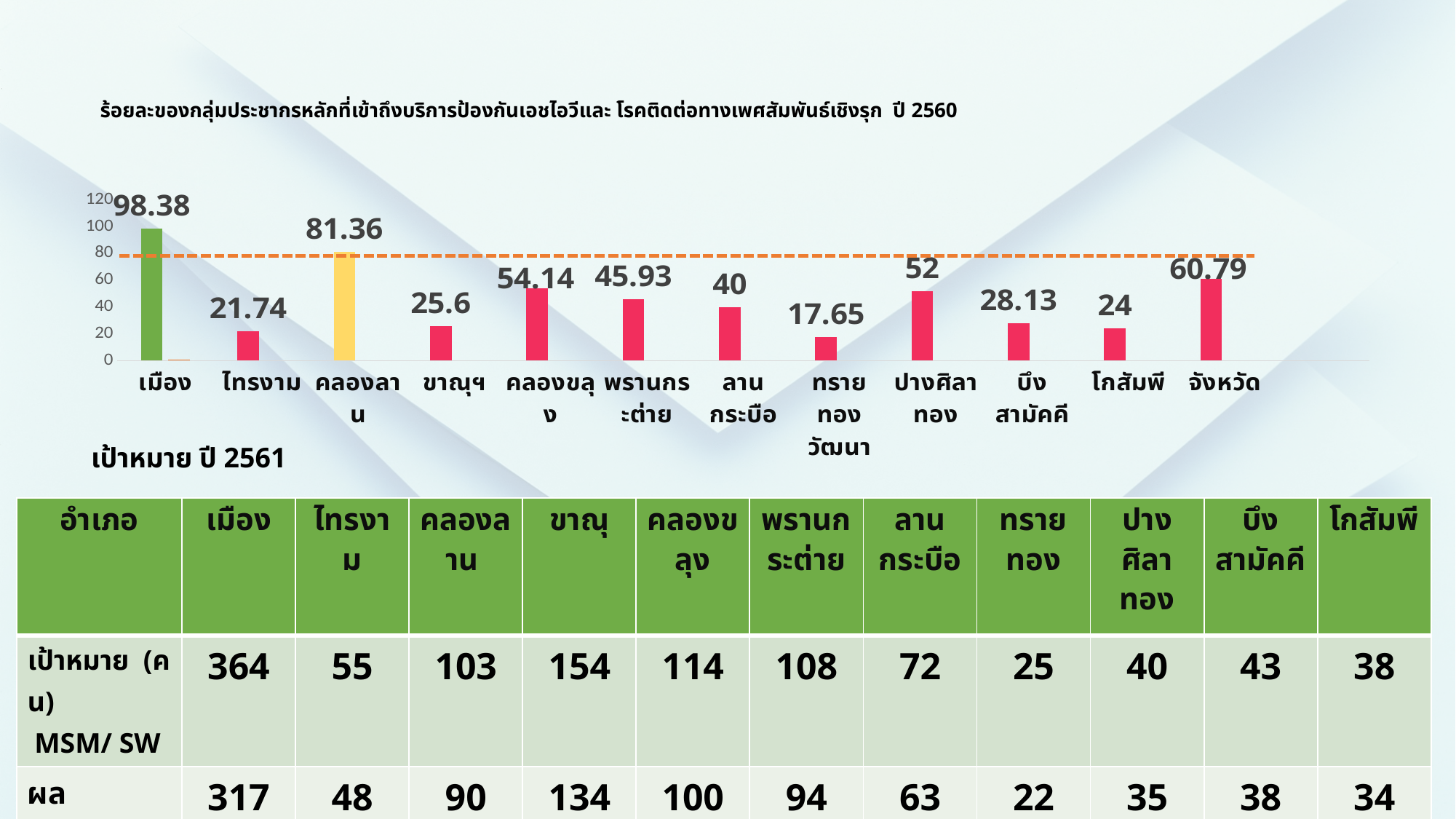
Which is larger, the value for คลองขลุง or the value for พรานกระต่าย? คลองขลุง What colour is the bar for เมือง in the chart? green What is the value for คลองลาน in the chart? 81.36 Which category has the lowest value in the chart? ทรายทองวัฒนา Is the value for ปางศิลาทอง greater or less than 40? greater What is the value for จังหวัด in the chart? 60.79 How many categories are shown on the x axis of the chart? 12 What type of chart is shown on the slide? bar chart What is the value for ทรายทองวัฒนา in the chart? 17.65 What is the difference between the values for เมือง and คลองลาน? 17.02 Which category has the highest value in the chart? เมือง What is the value for เมือง in the chart? 98.38